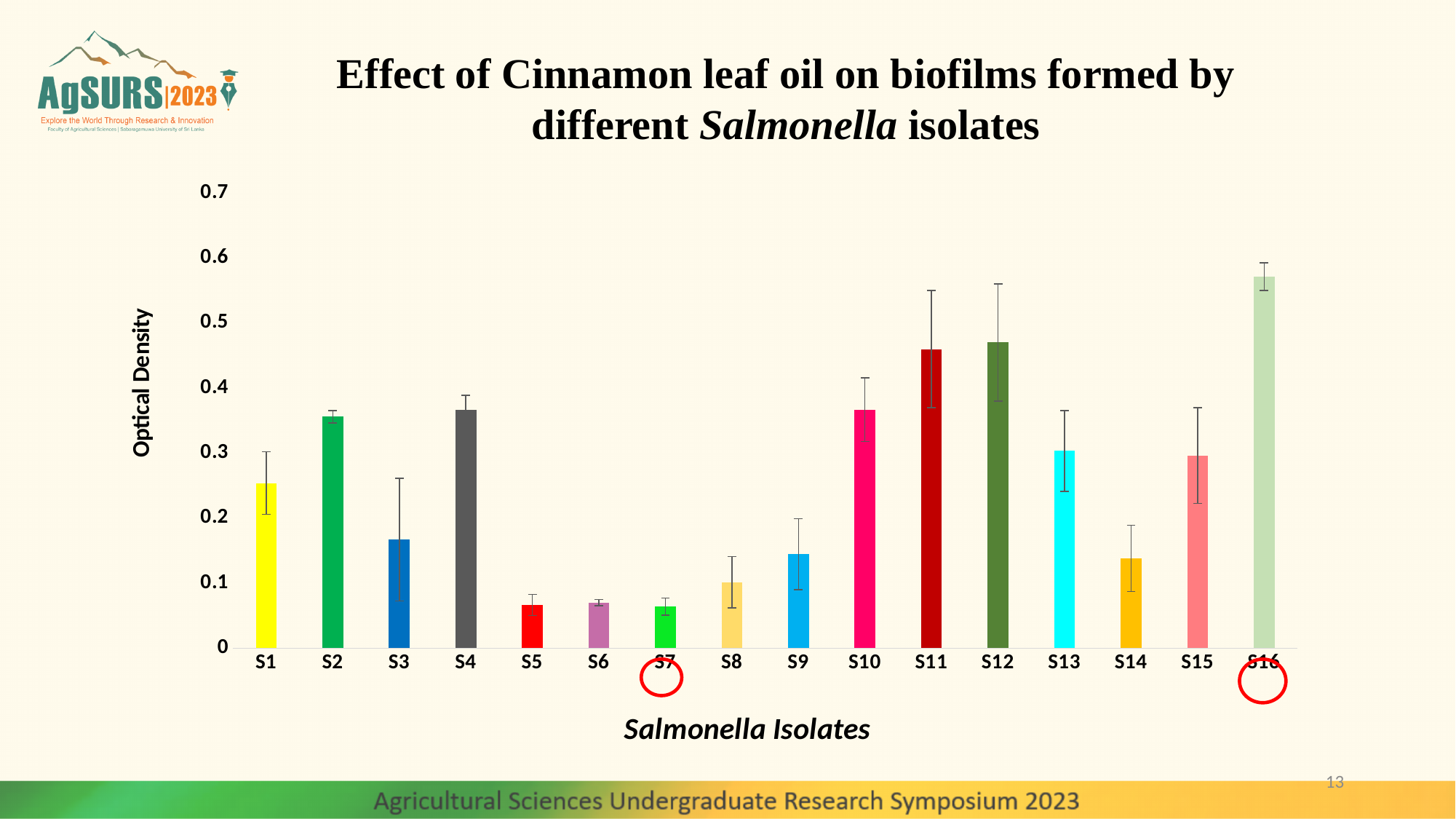
Which isolate has the highest optical density? S16 How many Salmonella isolates are plotted on the x axis? 16 Which has the higher optical density, S12 or S16? S16 Is the optical density for S16 greater or less than 0.5? greater What kind of chart is shown on the slide? bar chart Which has the higher optical density, S8 or S9? S9 What is the label of the y axis? Optical Density Is the optical density for S11 greater or less than 0.4? greater Is the optical density for S1 greater or less than 0.2? greater Which two isolate labels on the x axis are circled in red? S7 and S16